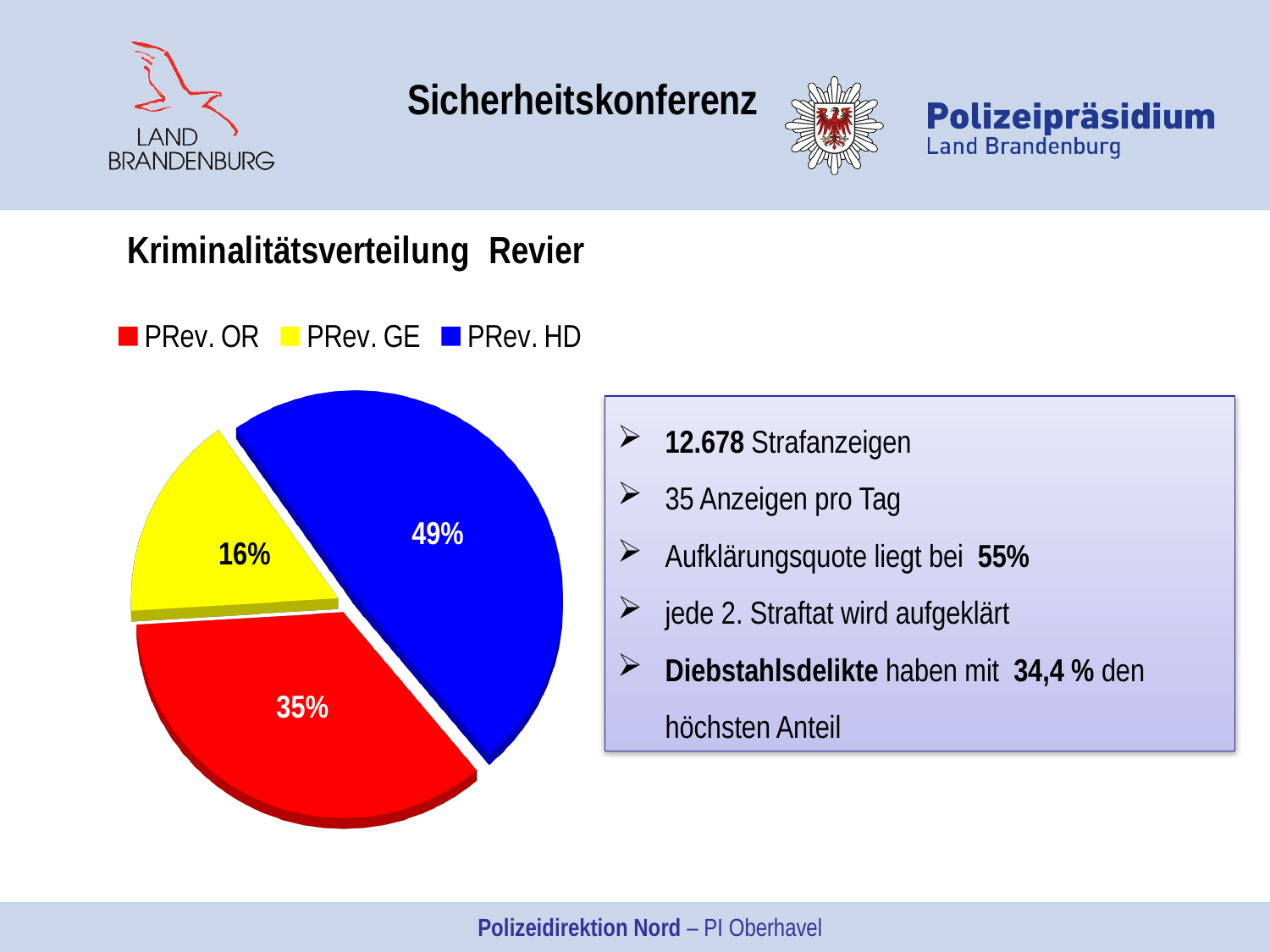
Which is larger, the slice for PRev. OR or the slice for PRev. GE? PRev. OR What share of the pie does PRev. OR have? 35% Which category has the largest slice of the pie? PRev. HD How many entries does the legend list? 3 What kind of chart is shown on the slide? pie chart What is the difference in percentage points between PRev. OR and PRev. GE? 19 What is the difference in percentage points between PRev. HD and PRev. OR? 14 Which category has the smallest slice of the pie? PRev. GE What colour is the slice for PRev. GE? yellow What share of the pie does PRev. GE have? 16% How many slices does the pie chart have? 3 What share of the pie does PRev. HD have? 49%